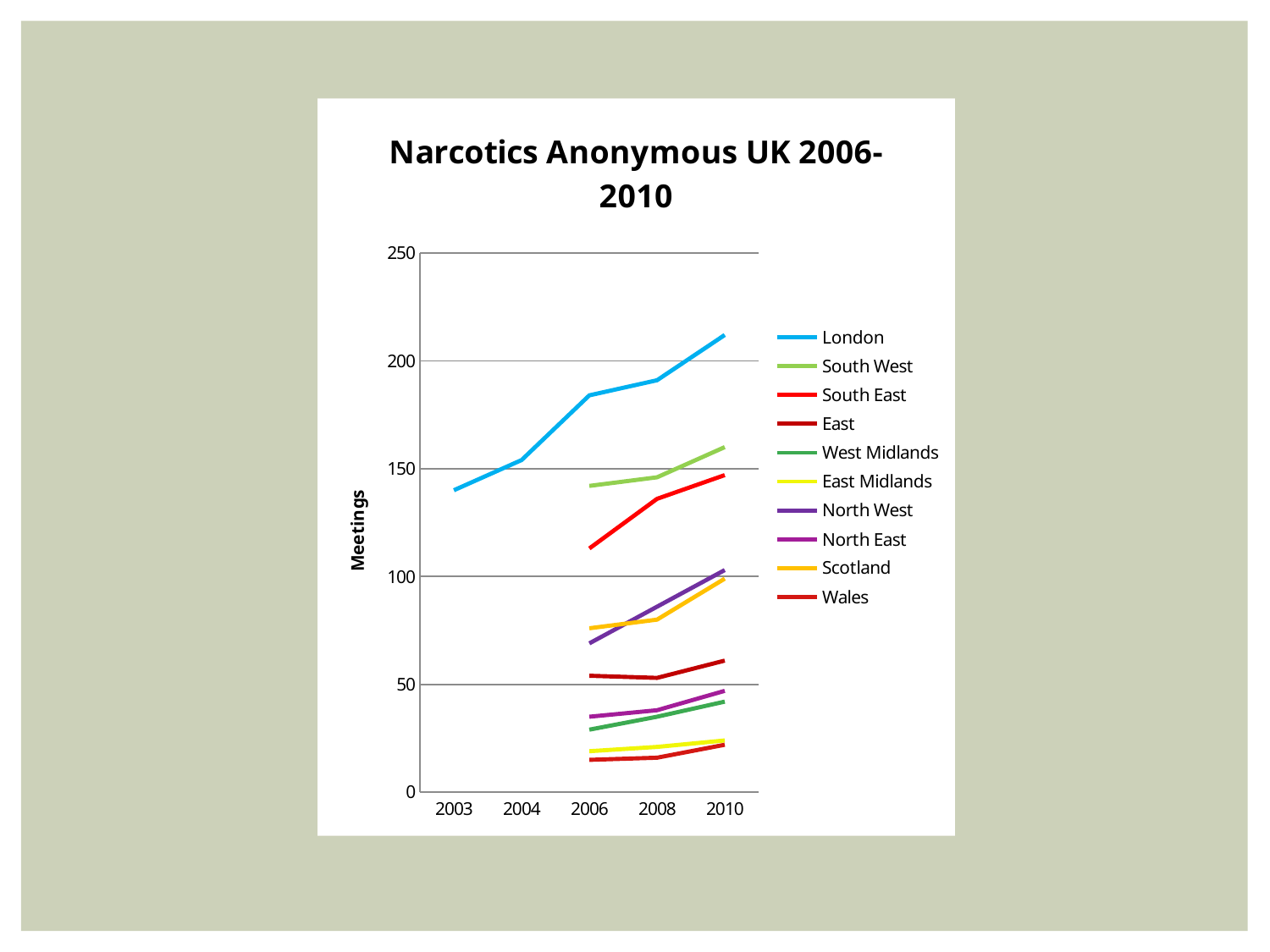
What kind of chart is shown on the slide? line chart Is the value for London in 2003 greater or less than 150? less Is the value for London in 2010 greater or less than 200? greater How many series does the legend list? 10 Is the value for South East in 2006 greater or less than 100? greater What is the label on the y axis? Meetings How many years are shown on the x axis? 5 Which region has the highest number of meetings in 2010? London Does the London line rise or fall from 2003 to 2010? rise Which is larger in 2010, London or South West? London